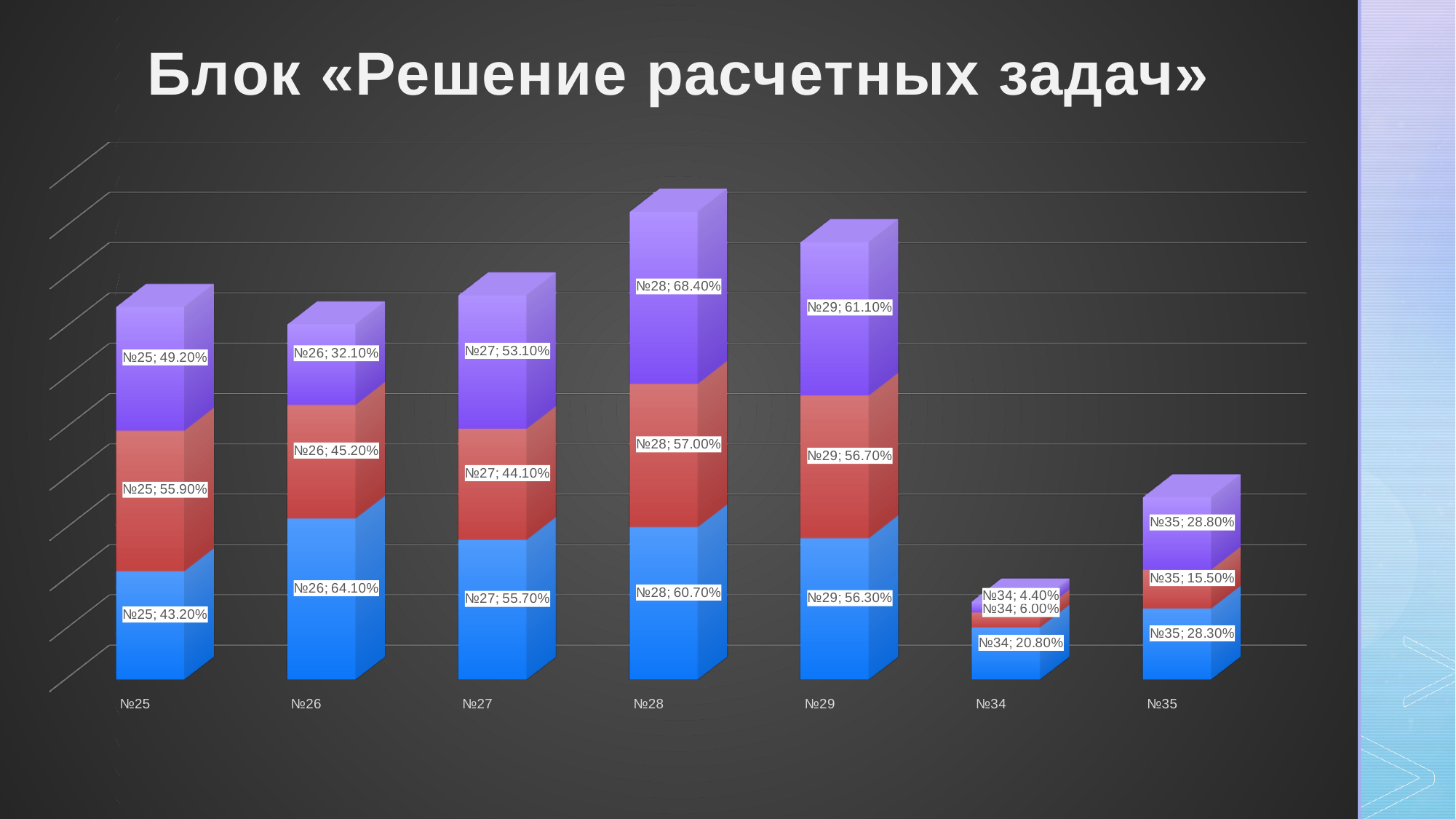
What is the total of the stacked bar for №34? 31.20% What is the title of the slide? Блок «Решение расчетных задач» Which is larger: the purple segment for №27 or the purple segment for №25? №27 What is the value of the purple (top) segment for №28? 68.40% Which category has the lowest value in the red (middle) segment? №34 What type of chart is shown on the slide? Stacked bar chart What is the value of the blue (bottom) segment for №34? 20.80% What is the value of the blue segment for №26? 64.10% What is the value of the red (middle) segment for №29? 56.70% What is the difference between the blue segment values of №26 and №25? 20.90% Which category has the highest value in the purple (top) segment? №28 How many categories are shown on the x axis? 7